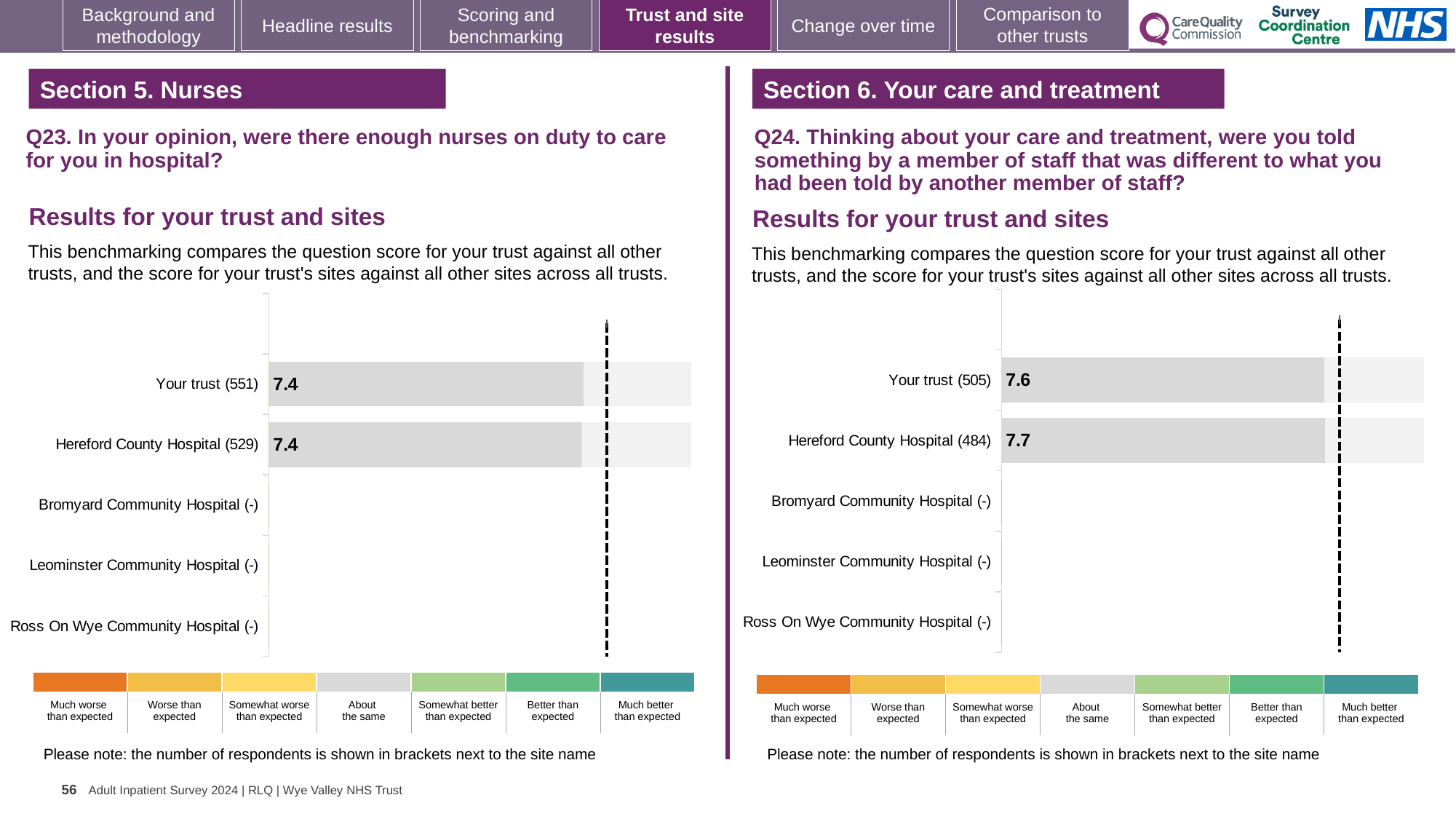
On the Q23 chart (left), what is the difference between the Your trust score and the Hereford County Hospital score? 0 What type of chart is used for the Q23 results (left)? Bar chart On the Q24 chart (right), what is the score for Your trust (505)? 7.6 On the Q23 chart (left), what is the score for Hereford County Hospital (529)? 7.4 How many site/trust categories are listed on the Q23 chart (left)? 5 On the Q24 chart (right), which has the higher score, Your trust or Hereford County Hospital? Hereford County Hospital How many categories does the colour key below the Q24 chart (right) list? 7 On the Q23 chart (left), how many respondents are shown for Hereford County Hospital? 529 On the Q24 chart (right), what is the score for Hereford County Hospital (484)? 7.7 On the Q23 chart (left), what is the score for Your trust (551)? 7.4 On the Q24 chart (right), what is the difference between the Hereford County Hospital score and the Your trust score? 0.1 How many site/trust categories are listed on the Q24 chart (right)? 5